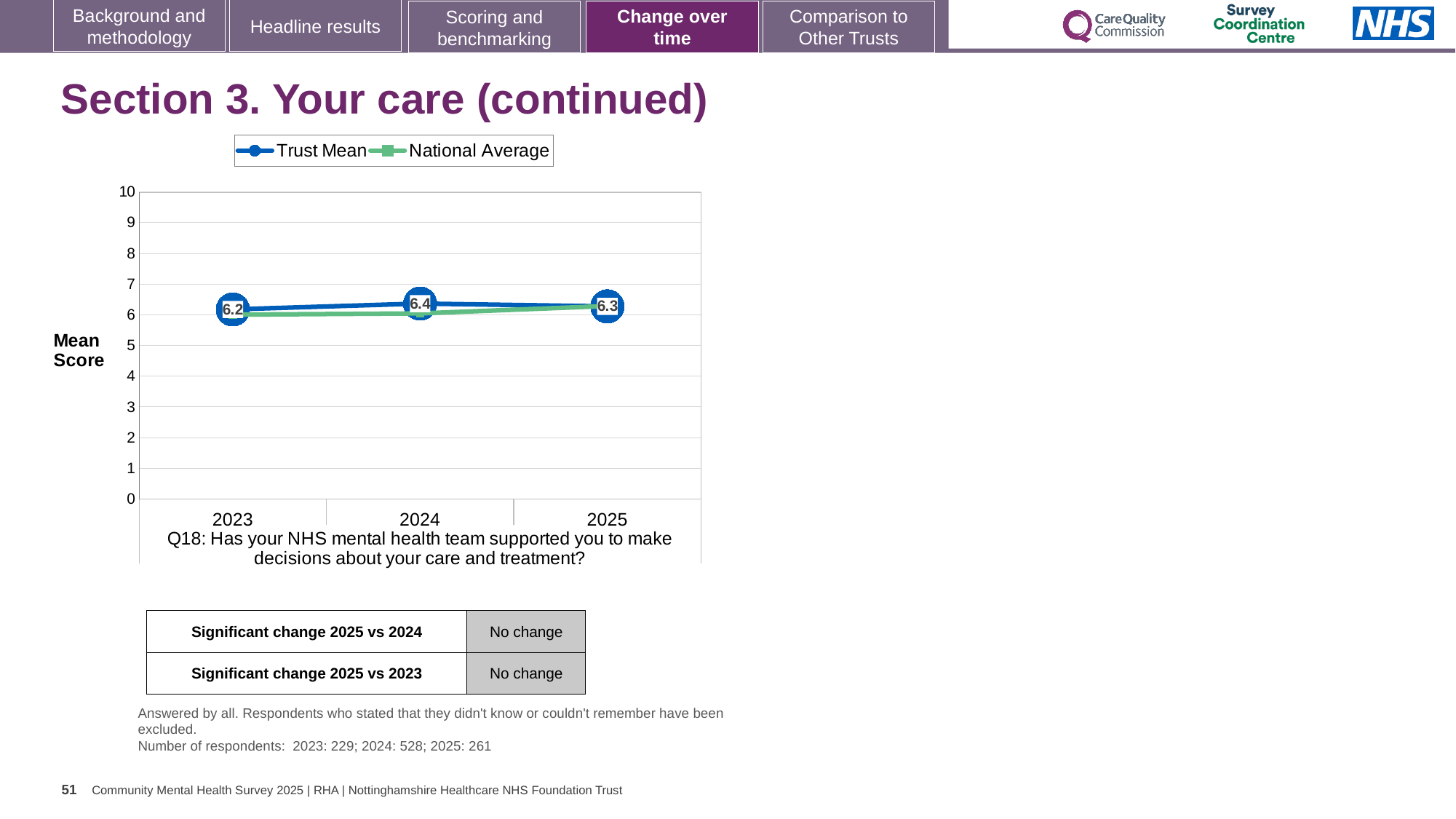
What is the Trust Mean score for 2024? 6.4 How many series does the legend list? 2 In which year is the Trust Mean highest? 2024 How many years are plotted on the x axis? 3 What kind of chart is shown on the slide? line chart What is the Trust Mean score for 2023? 6.2 Does the Trust Mean rise or fall from 2023 to 2024? rise What is the Trust Mean score for 2025? 6.3 Which is larger, the Trust Mean in 2024 or in 2025? 2024 In which year is the Trust Mean lowest? 2023 Is the National Average value for 2023 greater or less than 7? less What is the difference between the Trust Mean in 2024 and in 2023? 0.2